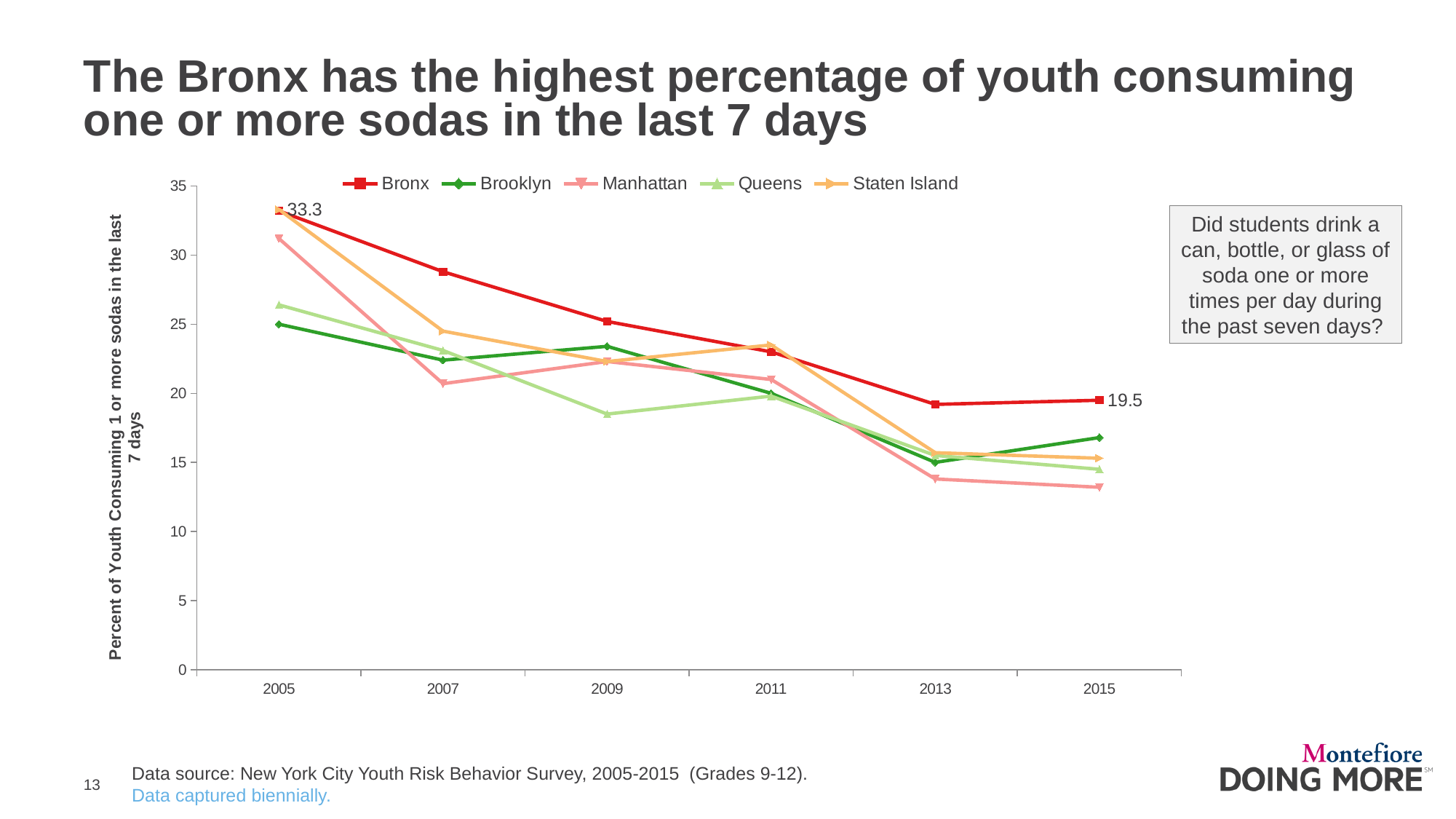
Is the value for Bronx in 2007 greater or less than 25? greater In 2005, which is larger, the value for Bronx or the value for Brooklyn? Bronx Which borough has the lowest value in 2015? Manhattan Is the value for Queens in 2009 greater or less than 20? less Is the value for Manhattan in 2015 greater or less than 15? less Which borough has the highest value in 2015? Bronx What kind of chart is shown on the slide? line chart What is the value for Bronx in 2015? 19.5 How many series does the legend list? 5 How many years are shown on the x axis? 6